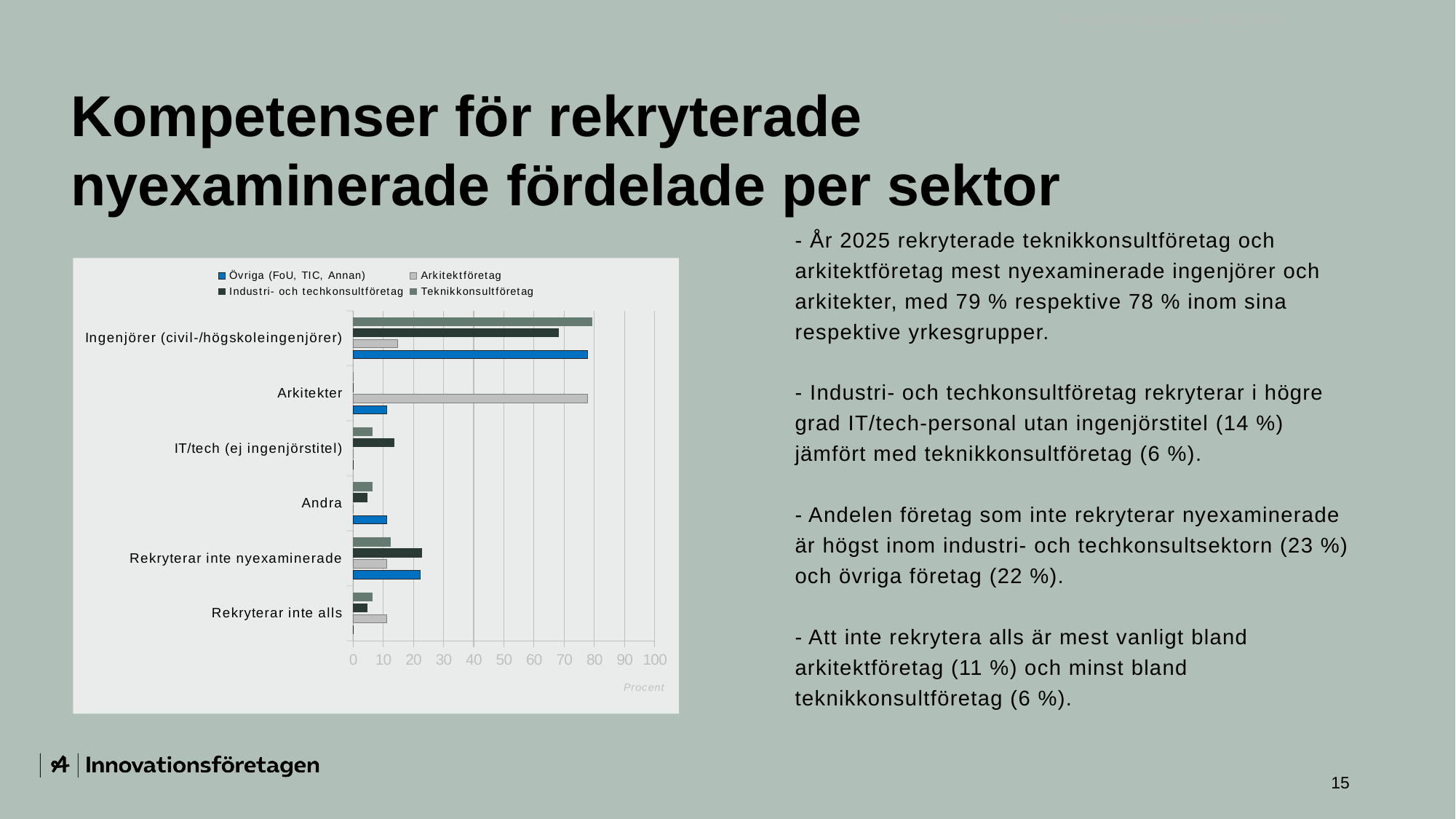
Which category has the highest value for the Arkitektföretag series? Arkitekter What kind of chart is shown on the slide? bar chart In the category IT/tech (ej ingenjörstitel), which series has the larger value: Industri- och techkonsultföretag or Teknikkonsultföretag? Industri- och techkonsultföretag How many series does the chart's legend list? 4 What label is shown on the horizontal axis of the chart? Procent In the category Rekryterar inte nyexaminerade, which series has the larger value: Industri- och techkonsultföretag or Arkitektföretag? Industri- och techkonsultföretag Is the value for Arkitektföretag in the category Ingenjörer (civil-/högskoleingenjörer) greater or less than 20? less Is the value for Teknikkonsultföretag in the category Ingenjörer (civil-/högskoleingenjörer) greater or less than 70? greater How many categories are shown on the vertical axis of the chart? 6 What colour represents the series Övriga (FoU, TIC, Annan) in the chart? blue Is the value for Arkitektföretag in the category Arkitekter greater or less than 70? greater